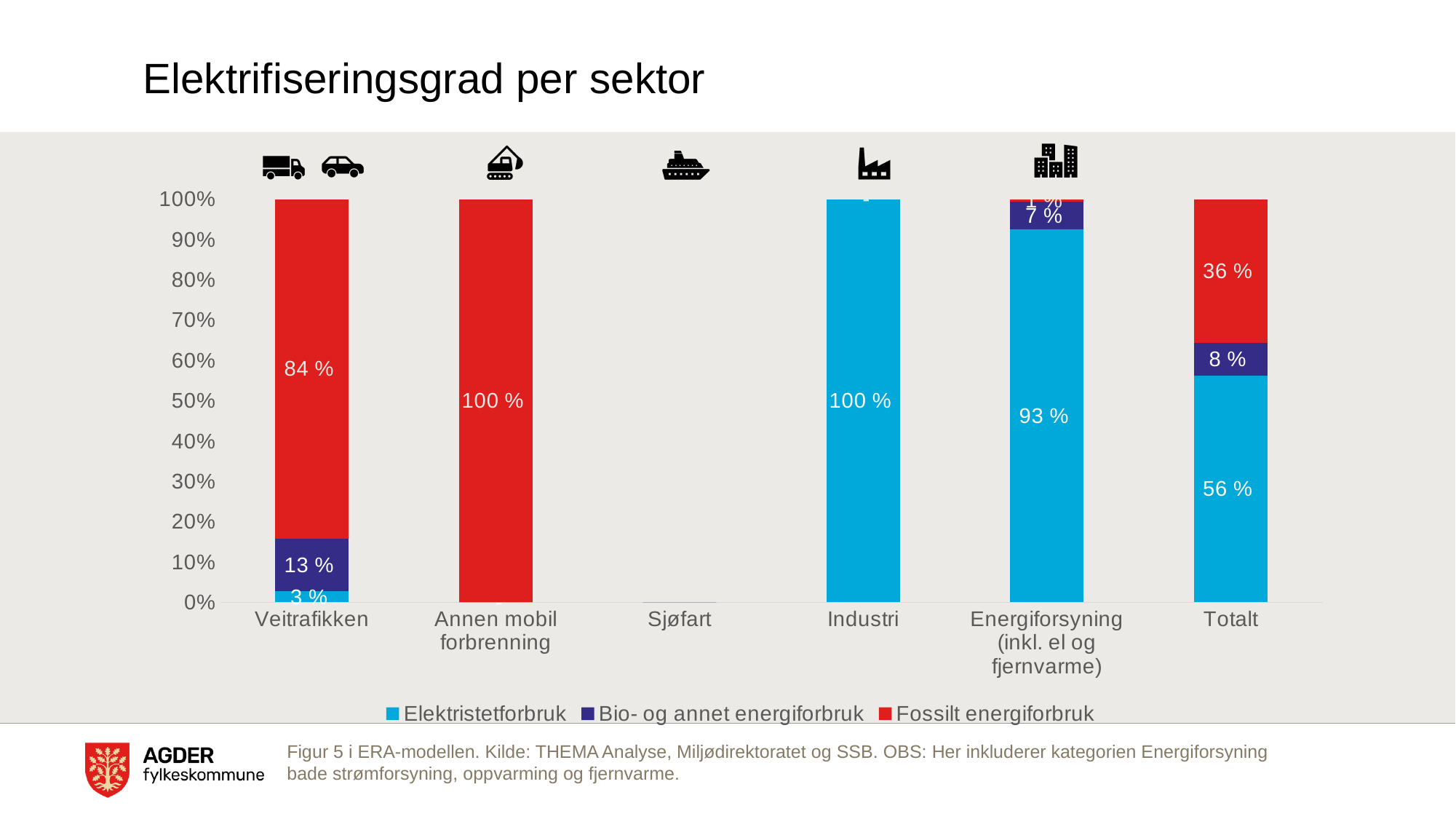
What is the Bio- og annet energiforbruk share for Veitrafikken? 13 % Which sector has the highest Elektristetforbruk share? Industri What is the Fossilt energiforbruk share for Veitrafikken? 84 % Which colour represents Fossilt energiforbruk in the chart? red What type of chart is shown on the slide? stacked bar chart What is the difference between the Fossilt energiforbruk share for Veitrafikken and for Totalt? 48 % What is the Fossilt energiforbruk share for Annen mobil forbrenning? 100 % How many sector categories are shown on the x axis? 6 How many series does the legend list? 3 What is the Elektristetforbruk share for Totalt? 56 % What is the Elektristetforbruk share for Energiforsyning (inkl. el og fjernvarme)? 93 % Which is larger: the Bio- og annet energiforbruk share for Totalt or for Energiforsyning (inkl. el og fjernvarme)? Totalt